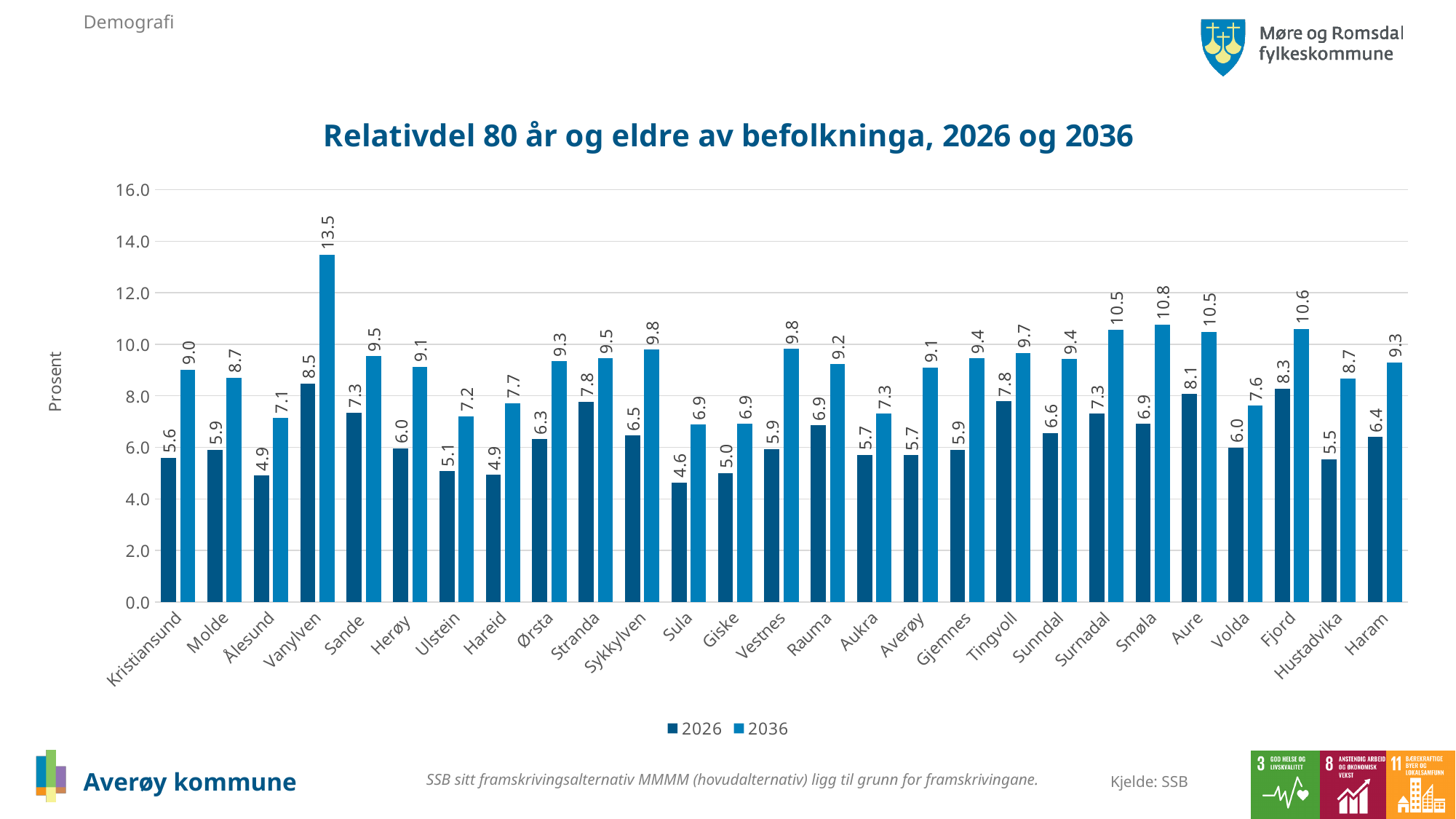
How many series does the legend list? 2 Which is larger, the 2026 value for Fjord or the 2026 value for Volda? Fjord What is the 2036 value for Vanylven? 13.5 What is the title of the chart? Relativdel 80 år og eldre av befolkninga, 2026 og 2036 What is the 2036 value for Smøla? 10.8 What is the 2026 value for Averøy? 5.7 What is the difference between the 2036 and 2026 values for Vanylven? 5.0 Which municipality has the lowest 2026 value? Sula What kind of chart is shown on the slide? Bar chart Which municipality has the highest 2036 value? Vanylven What is the difference between the 2036 and 2026 values for Averøy? 3.4 How many municipalities are shown on the x axis? 27